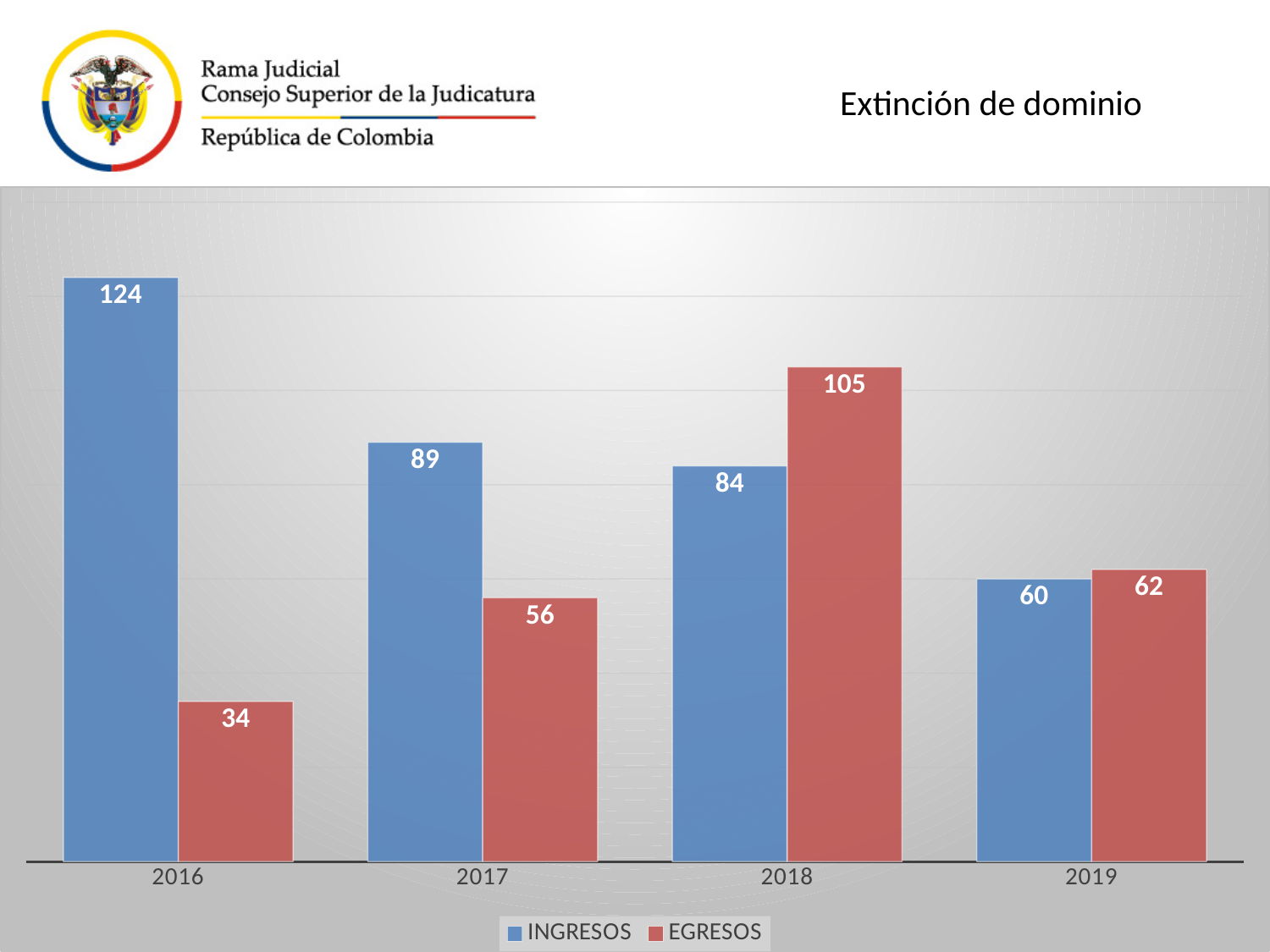
What is the EGRESOS value for 2018? 105 How many series does the legend list? 2 What is the INGRESOS value for 2016? 124 What kind of chart is shown on the slide? Bar chart What is the EGRESOS value for 2017? 56 Which year has the lowest EGRESOS value? 2016 Do the INGRESOS values rise or fall from 2016 to 2019? Fall In 2018, which is larger, INGRESOS or EGRESOS? EGRESOS What is the difference between INGRESOS and EGRESOS in 2016? 90 How many years are shown on the x axis? 4 What is the difference between EGRESOS in 2018 and EGRESOS in 2017? 49 Which year has the highest INGRESOS value? 2016